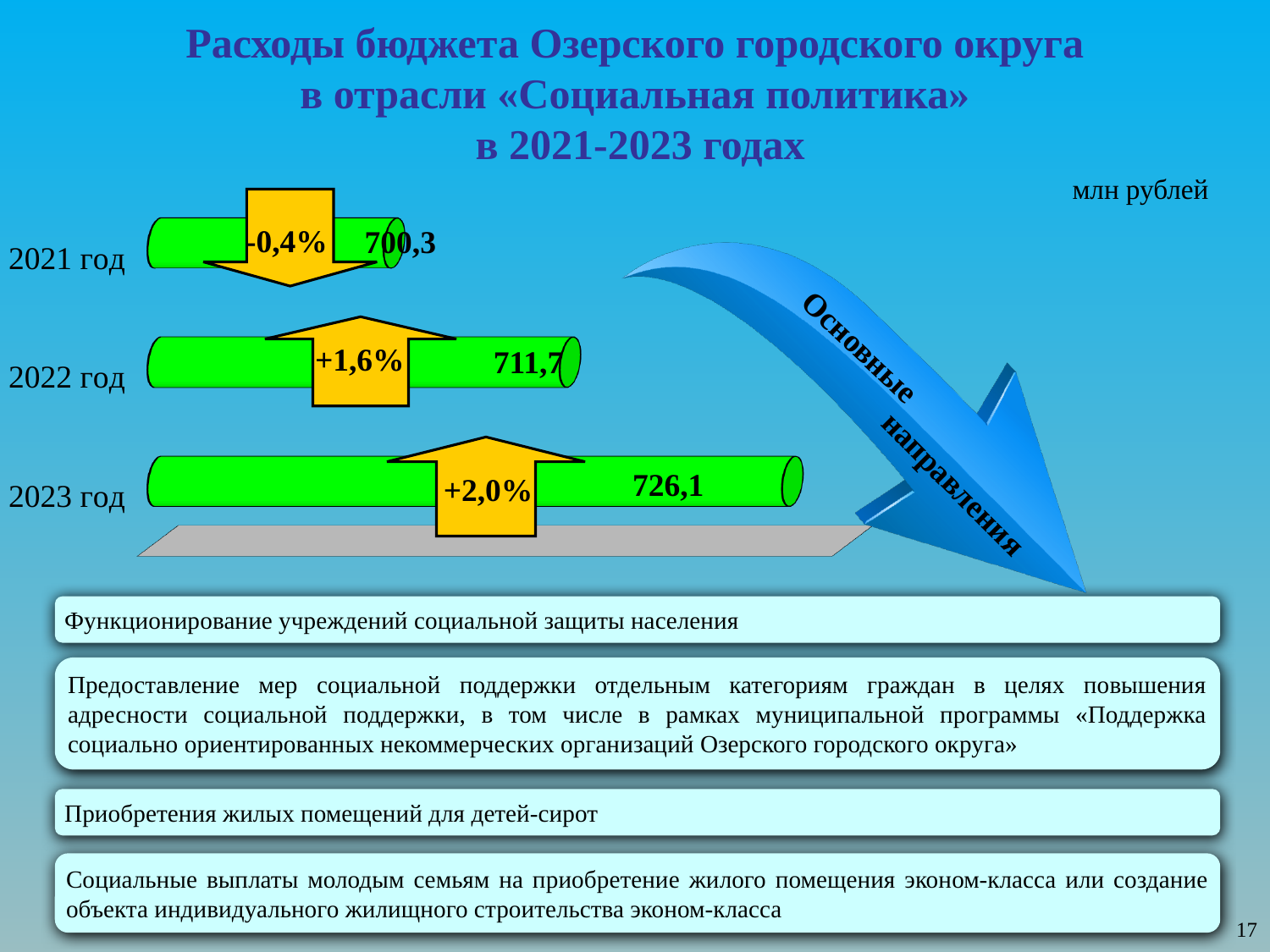
How many years (bars) are shown in the chart? 3 What is the budget expenditure value shown for 2023 год? 726,1 What is the budget expenditure value shown for 2022 год? 711,7 What is the budget expenditure value shown for 2021 год? 700,3 What percentage change is shown on the arrow for 2022 год? +1,6% What is the difference between the values for 2022 год and 2021 год? 11,4 What is the difference between the values for 2023 год and 2021 год? 25,8 Which is larger, the value for 2022 год or the value for 2023 год? 2023 год What percentage change is shown on the arrow for 2023 год? +2,0% Which year has the lowest expenditure value? 2021 год Which year has the highest expenditure value? 2023 год In what units are the chart values expressed? млн рублей